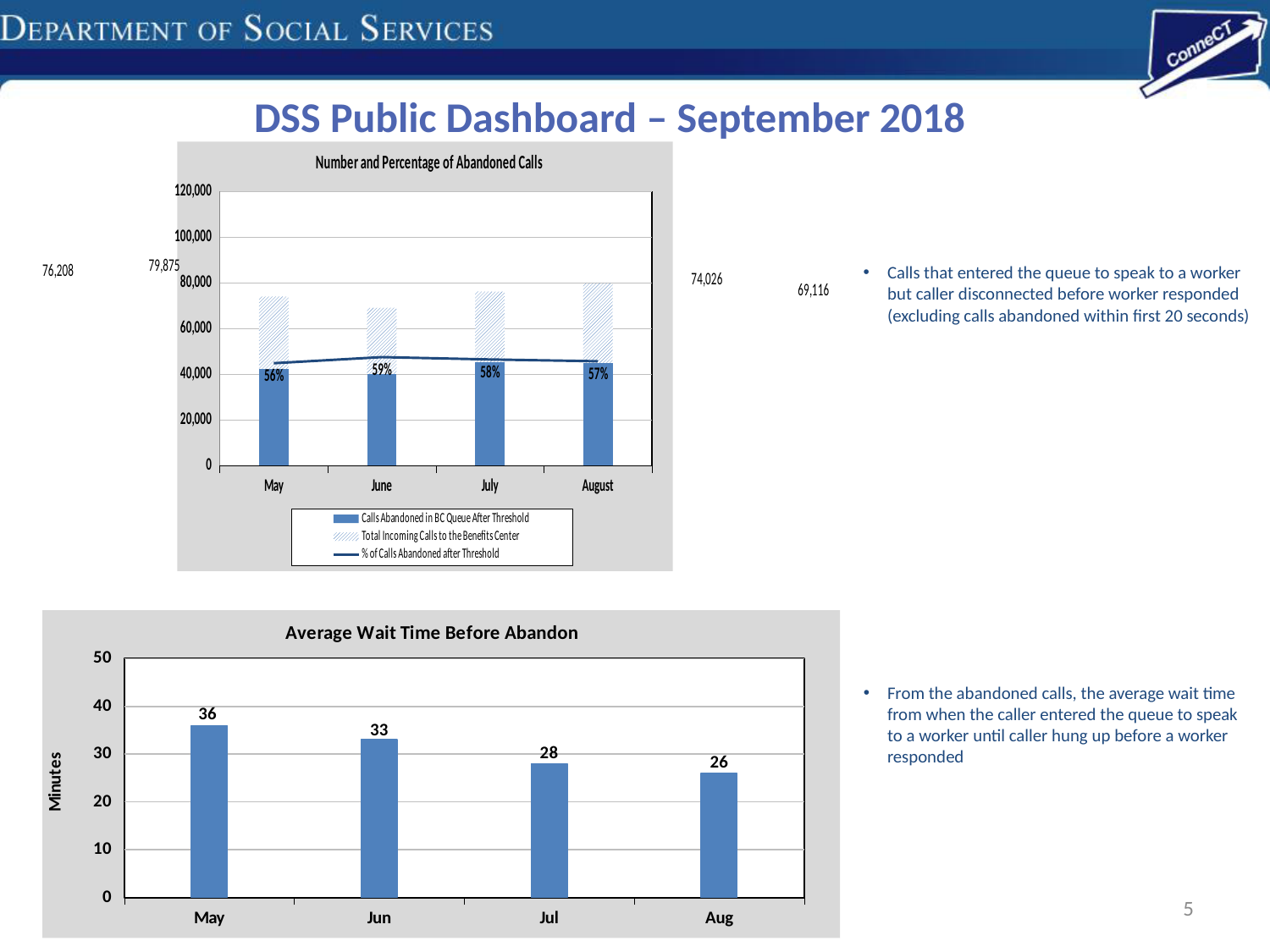
In the 'Number and Percentage of Abandoned Calls' chart, which month has the lowest percentage of calls abandoned after threshold? May In the 'Number and Percentage of Abandoned Calls' chart, is the value for Total Incoming Calls to the Benefits Center in June greater or less than 80,000? less In the 'Average Wait Time Before Abandon' chart, which month has the highest average wait time? May In the 'Average Wait Time Before Abandon' chart, what unit is shown on the vertical axis? Minutes In the 'Average Wait Time Before Abandon' chart, what is the difference between the May and Aug values? 10 In the 'Average Wait Time Before Abandon' chart, what is the value for Aug? 26 In the 'Average Wait Time Before Abandon' chart, what is the average wait time for May? 36 In the 'Number and Percentage of Abandoned Calls' chart, how many series does the legend list? 3 In the 'Average Wait Time Before Abandon' chart, which month has the lowest average wait time? Aug In the 'Number and Percentage of Abandoned Calls' chart, how many months are shown on the x axis? 4 In the 'Average Wait Time Before Abandon' chart, do the values rise or fall from May to Aug? fall In the 'Number and Percentage of Abandoned Calls' chart, what is the percentage of calls abandoned after threshold for June? 59%